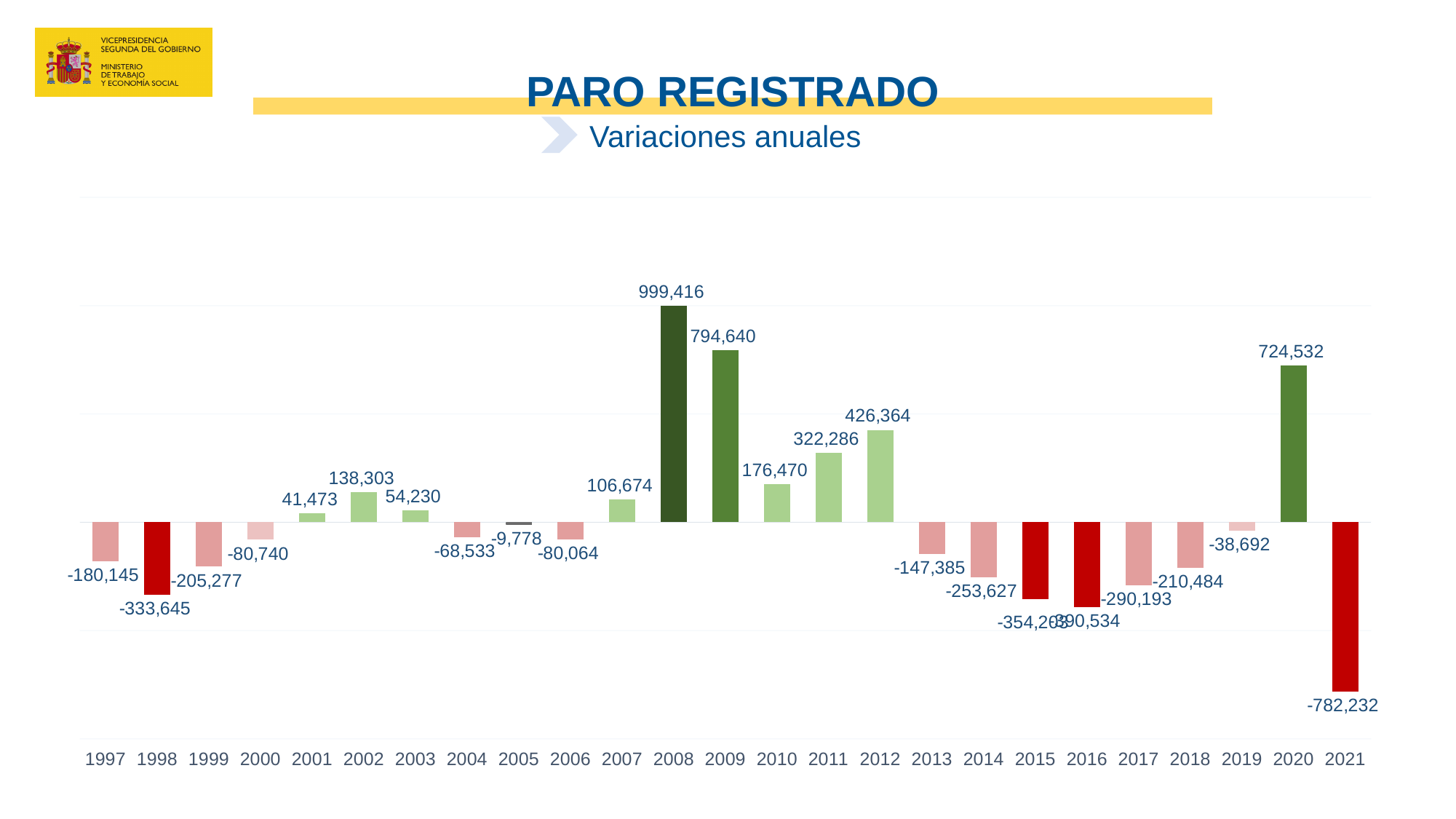
What is the value for 2021? -782,232 What is the difference between the values for 2008 and 2009? 204,776 Which year has the highest value? 2008 What colour are the bars with negative values? Red What is the value for 2008? 999,416 What is the value for 2020? 724,532 Which is larger, the value for 2011 or the value for 2010? 2011 What is the value for 2012? 426,364 What is the title of the chart? PARO REGISTRADO - Variaciones anuales Which year has the lowest value? 2021 What kind of chart is shown on the slide? Bar chart How many years are shown on the x axis? 25